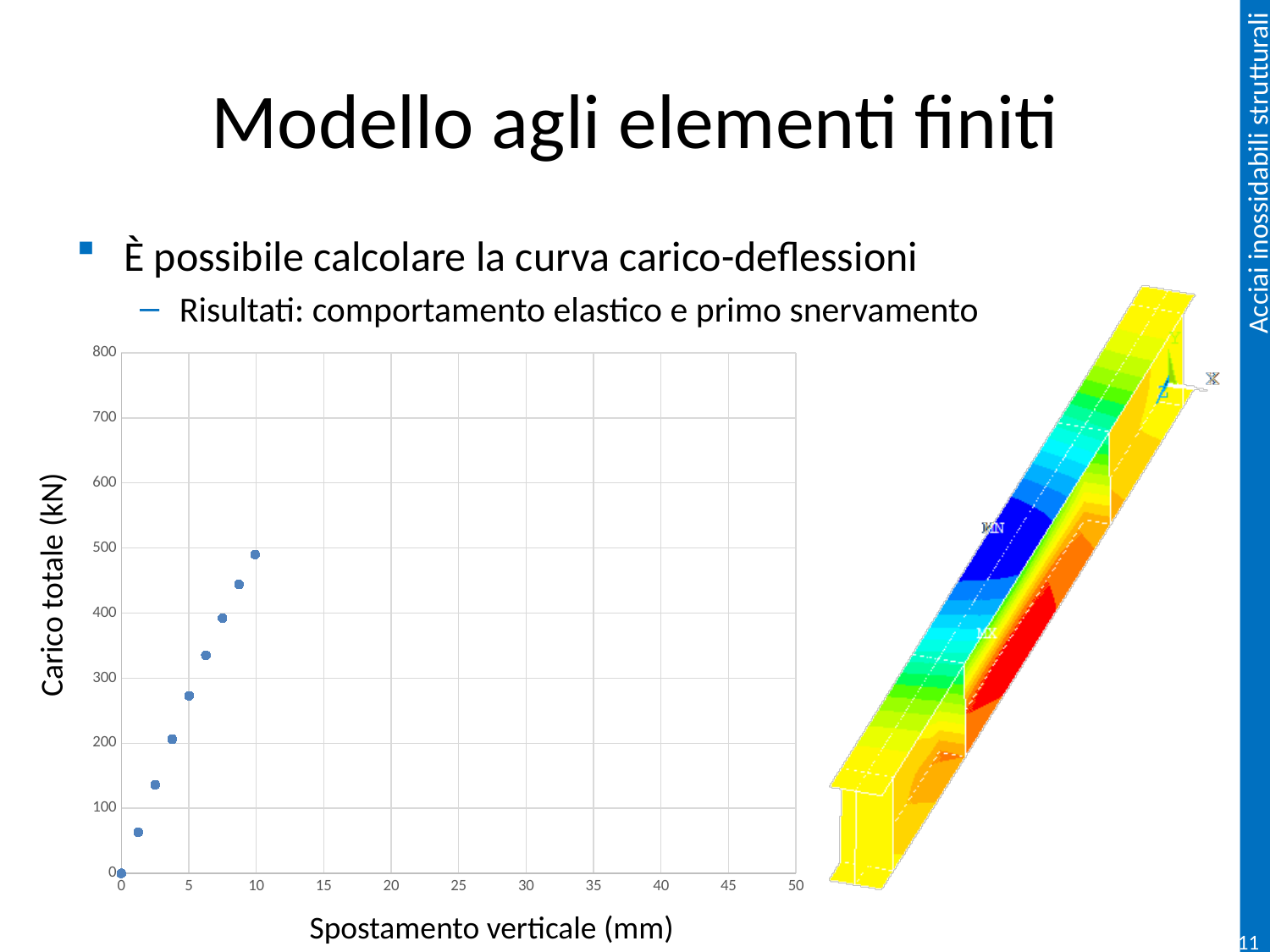
Do the plotted values rise or fall as the vertical displacement increases along the x axis? rise What kind of chart is shown on the slide? scatter chart What is the title of the horizontal axis of the chart? Spostamento verticale (mm) Is the displacement of the furthest-right plotted point greater or less than 15 mm? less Is the load value of the highest plotted point greater or less than 600 kN? less Is the load value of the point at about 5 mm displacement greater or less than 200 kN? greater How many data points are plotted on the chart? 9 What is the title of the vertical axis of the chart? Carico totale (kN) What is the maximum value shown on the vertical axis of the chart? 800